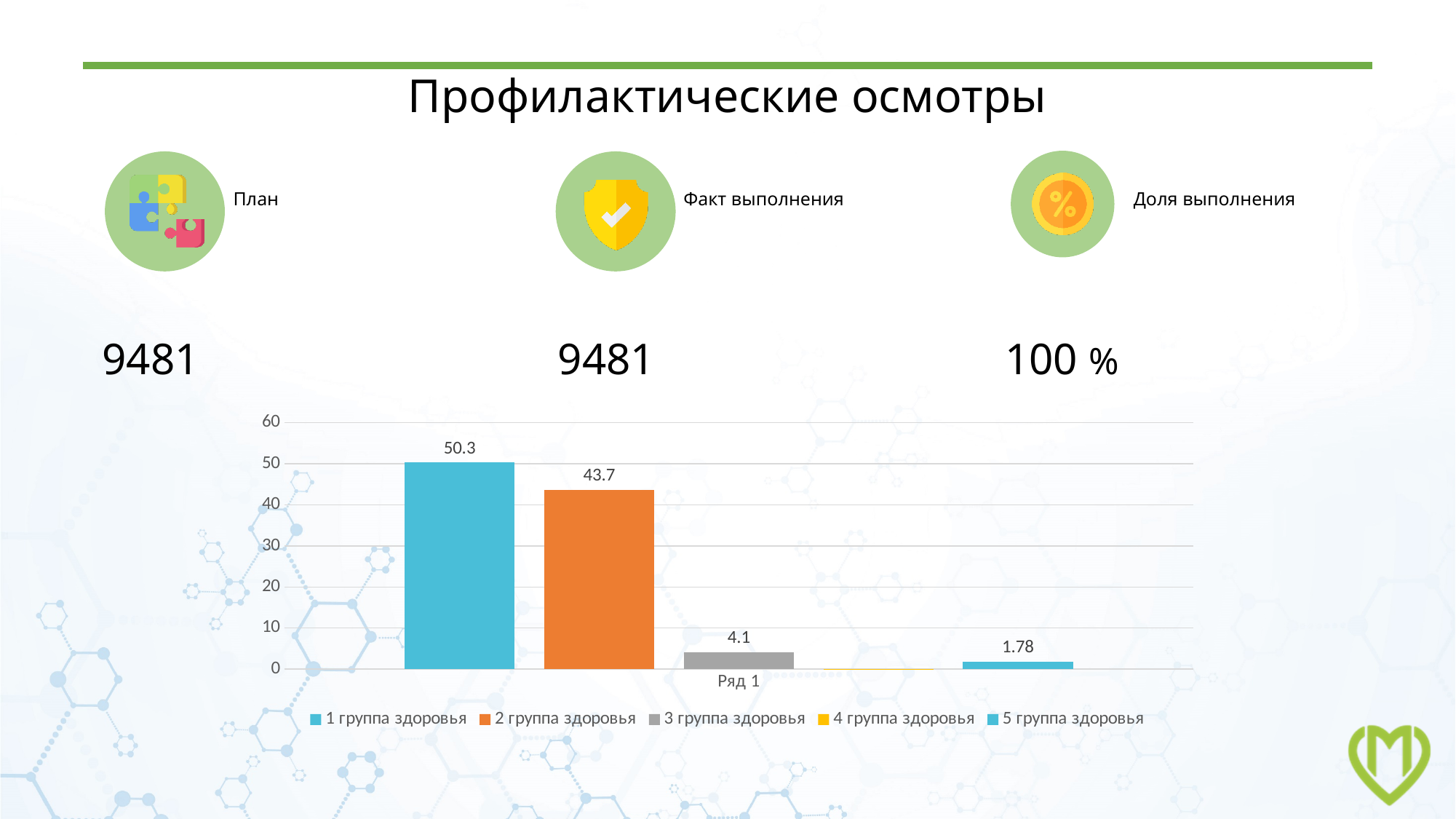
Is the value for 2 группа здоровья greater or less than 40? greater What value is shown for 2 группа здоровья? 43.7 What colour is the bar for 2 группа здоровья? orange What is the difference between the values for 2 группа здоровья and 3 группа здоровья? 39.6 Which health group has the highest value in the chart? 1 группа здоровья Which is larger, the value for 3 группа здоровья or 5 группа здоровья? 3 группа здоровья What kind of chart is shown on the slide? bar chart What value is shown for 3 группа здоровья? 4.1 What value is shown for 5 группа здоровья? 1.78 How many series does the legend list? 5 What is the difference between the values for 1 группа здоровья and 2 группа здоровья? 6.6 What value is shown for 1 группа здоровья? 50.3